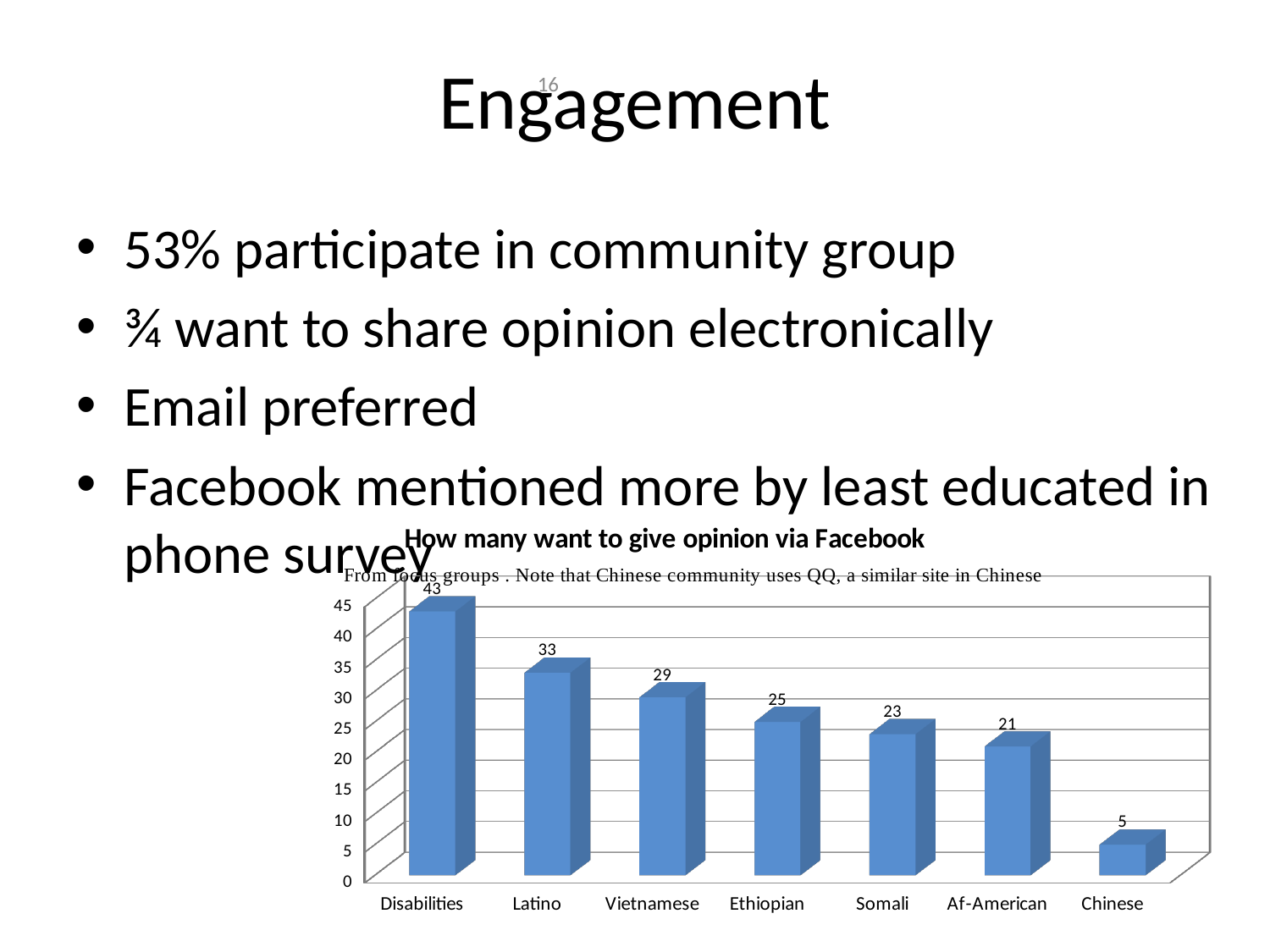
Do the values rise or fall from left to right across the categories? fall What is the title of the chart? How many want to give opinion via Facebook Which category has the highest value in the chart? Disabilities What kind of chart is shown on the slide? bar chart Which category has the lowest value in the chart? Chinese How many categories are shown in the chart? 7 Which is larger, the value for Somali or the value for Af-American? Somali What is the value for Disabilities in the chart? 43 What is the value for Chinese in the chart? 5 Is the value for Latino greater or less than 30? greater What is the value for Latino in the chart? 33 What is the difference between the values for Vietnamese and Ethiopian? 4